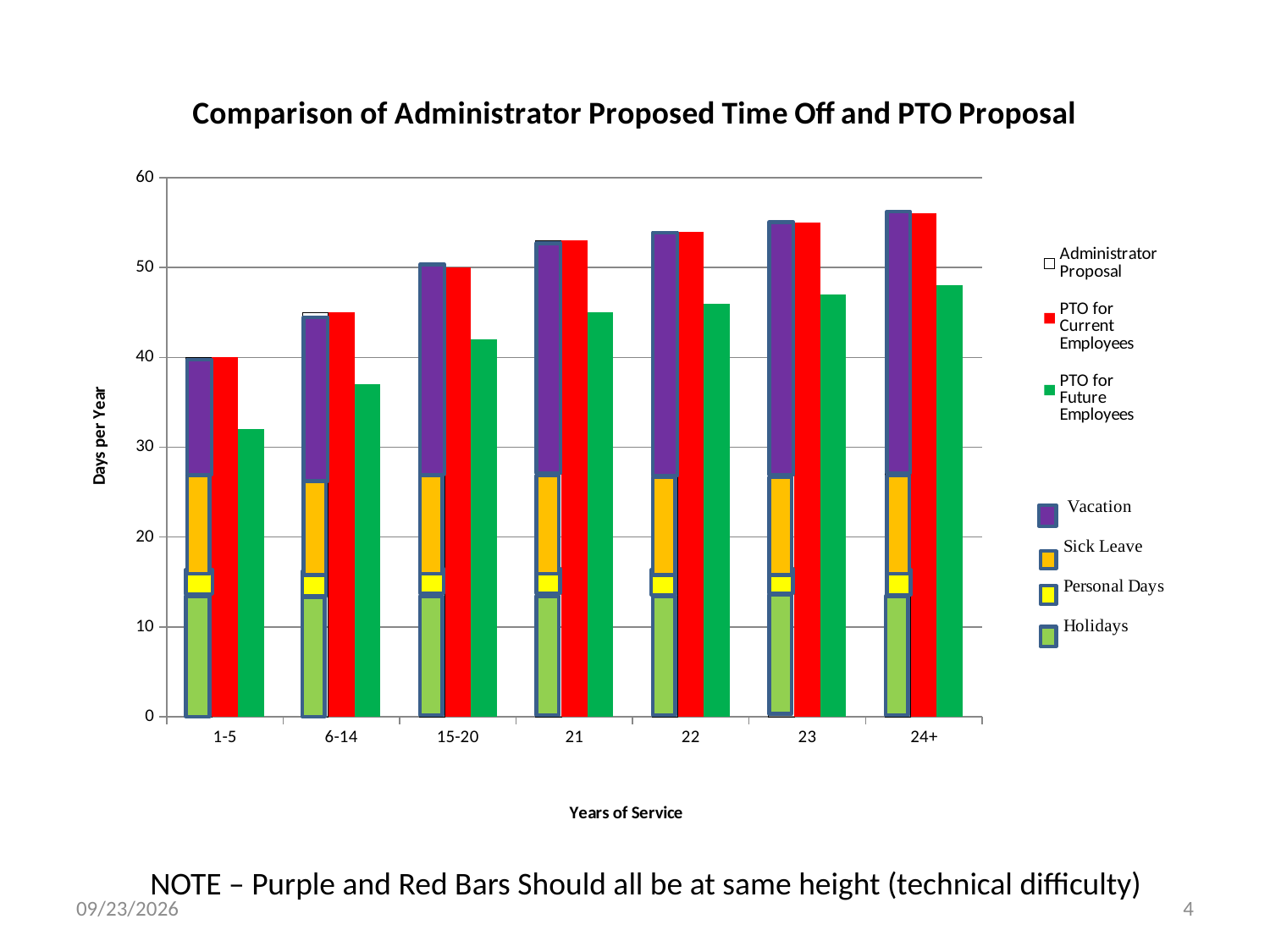
What is the value for PTO for Current Employees at 15-20 years of service? 50 Which years-of-service category has the lowest value for PTO for Future Employees? 1-5 How many series does the chart legend list (Administrator Proposal, PTO for Current Employees, PTO for Future Employees)? 3 How many years-of-service categories are shown on the x axis? 7 Is the value for PTO for Current Employees at 24+ years greater or less than 50? greater Is the value for PTO for Future Employees at 6-14 years greater or less than 40? less What is the value for PTO for Current Employees at 1-5 years of service? 40 Do the values for PTO for Future Employees rise or fall as years of service increase along the x axis? rise Is the value for PTO for Future Employees at 24+ years greater or less than 50? less At 1-5 years of service, which is larger: PTO for Current Employees or PTO for Future Employees? PTO for Current Employees What kind of chart is shown on the slide? bar chart Which years-of-service category has the highest value for PTO for Future Employees? 24+